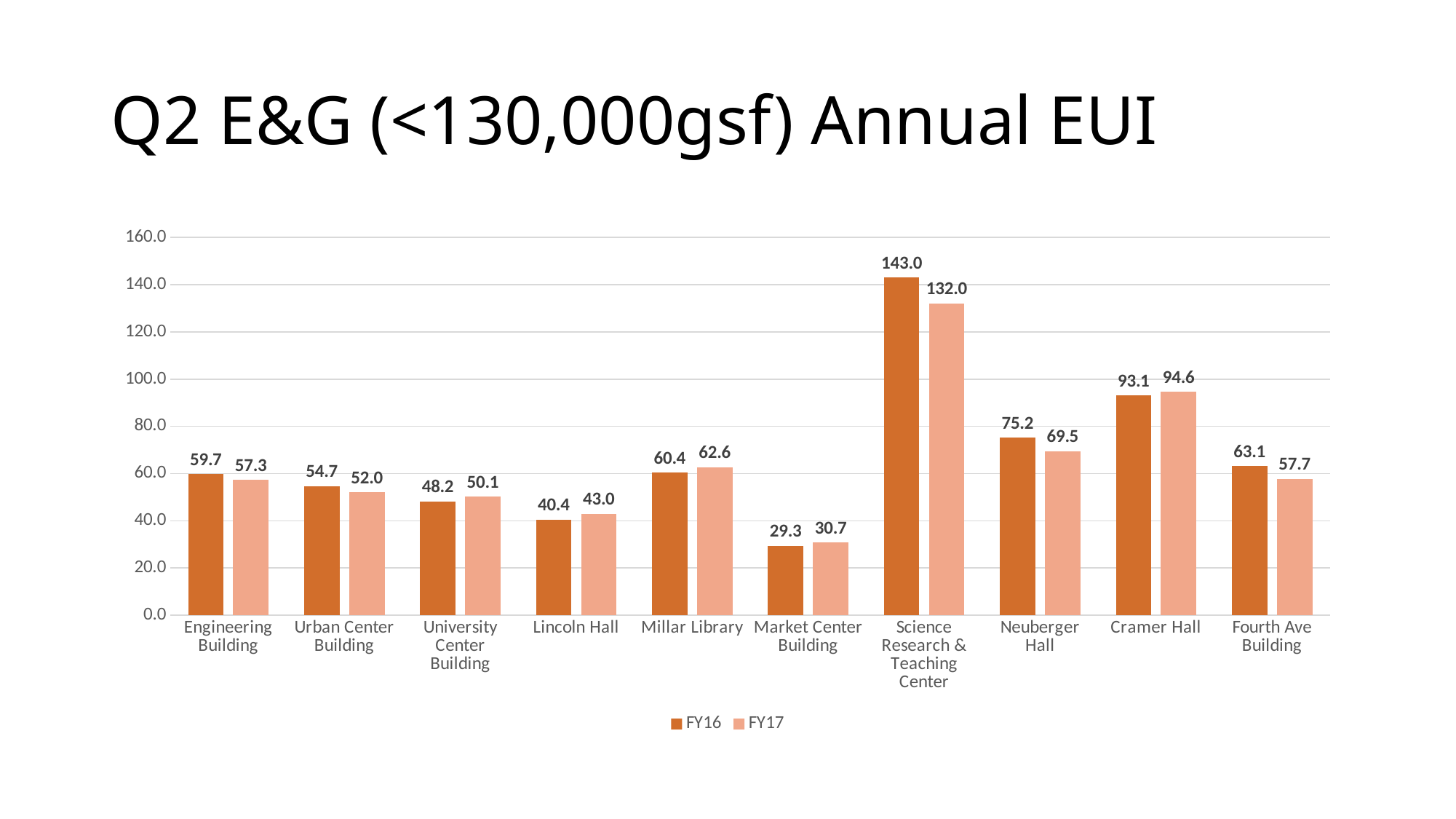
How many series does the legend list? 2 How many buildings are shown on the x axis? 10 What kind of chart is shown on the slide? Bar chart Which building has the lowest FY17 value? Market Center Building Which building has the highest FY16 value? Science Research & Teaching Center What is the FY16 value for Science Research & Teaching Center? 143.0 Which is larger for Millar Library, the FY16 value or the FY17 value? FY17 What is the difference between the FY17 values for Cramer Hall and Fourth Ave Building? 36.9 What is the FY17 value for Neuberger Hall? 69.5 What is the difference between the FY16 and FY17 values for Science Research & Teaching Center? 11.0 What is the FY17 value for Lincoln Hall? 43.0 Is the FY16 value for Neuberger Hall greater or less than 80.0? less